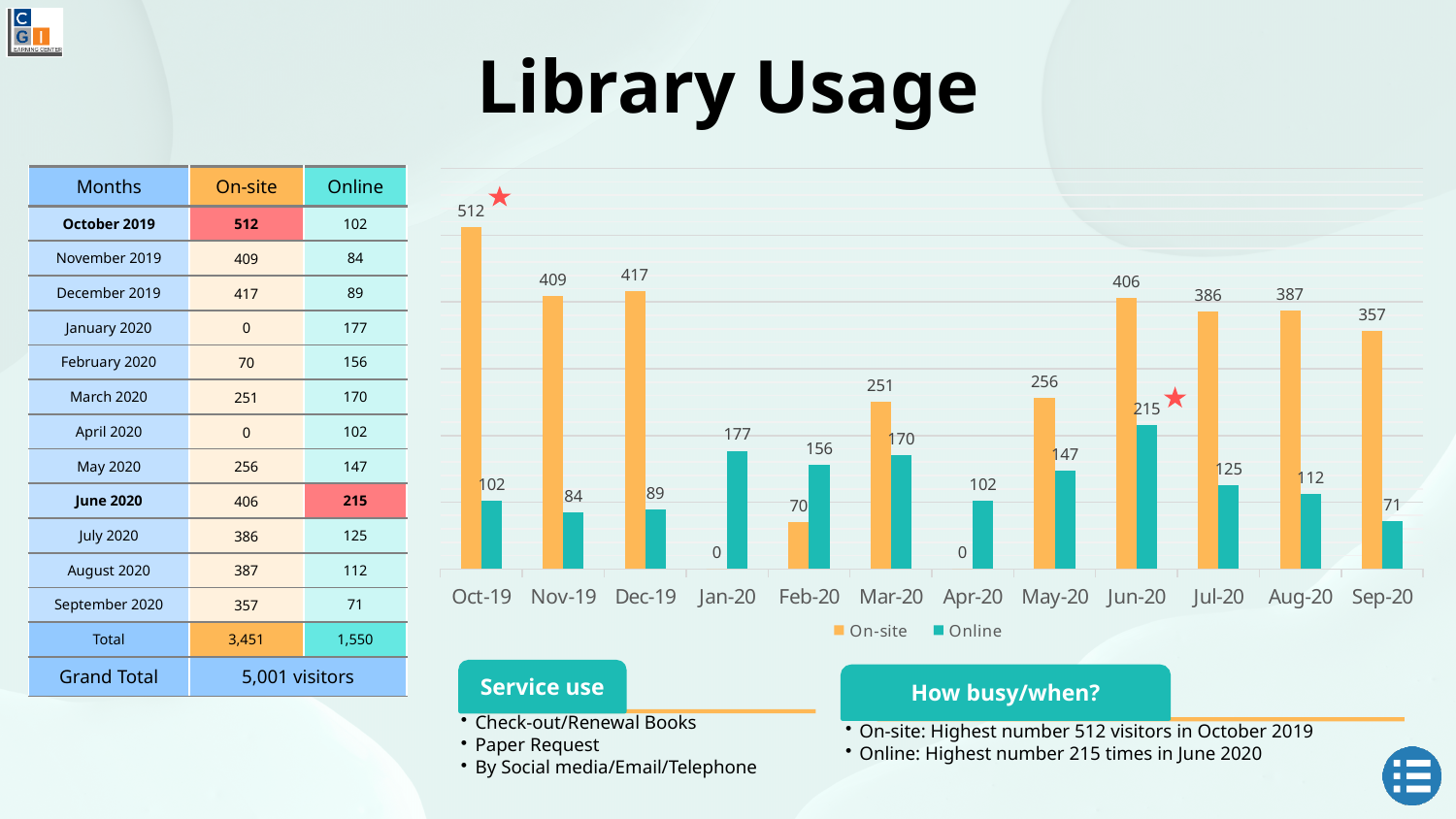
What is the Online value for Jun-20? 215 What is the On-site value for Oct-19? 512 Which month has the lowest Online value? Sep-20 Do the On-site values rise or fall from Jun-20 to Sep-20? Fall What is the difference between the On-site and Online values for Mar-20? 81 Which month has the highest On-site value? Oct-19 What is the On-site value for Sep-20? 357 How many months are shown on the x axis? 12 What colour are the On-site bars? Orange What kind of chart is shown? Bar chart How many series does the legend list? 2 Which is larger for Jan-20, the On-site value or the Online value? Online